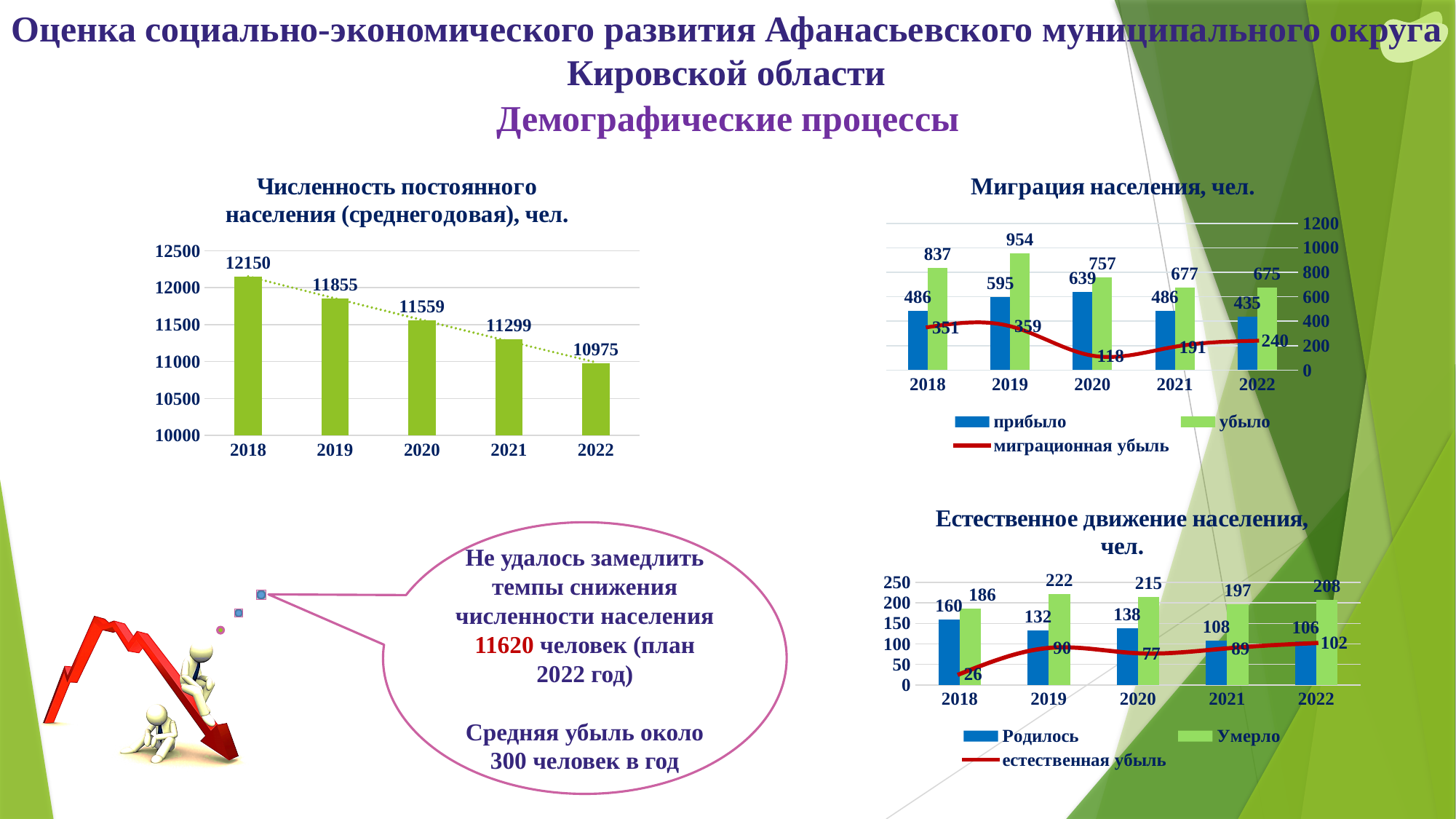
In the chart 'Численность постоянного населения (среднегодовая), чел.', do the values rise or fall from 2018 to 2022? fall In the chart 'Численность постоянного населения (среднегодовая), чел.', what is the value for 2020? 11559 In the chart 'Естественное движение населения, чел.', what is the value of 'Умерло' for 2021? 197 In the chart 'Миграция населения, чел.', which year has the lowest value of 'миграционная убыль'? 2020 In the chart 'Естественное движение населения, чел.', which is larger in 2019: 'Родилось' or 'Умерло'? Умерло In the chart 'Численность постоянного населения (среднегодовая), чел.', how many years are shown? 5 In the chart 'Численность постоянного населения (среднегодовая), чел.', what is the difference between the 2018 and 2022 values? 1175 In the chart 'Миграция населения, чел.', which year has the highest value of 'прибыло'? 2020 In the chart 'Миграция населения, чел.', what is the value of 'убыло' for 2019? 954 What kind of chart is 'Численность постоянного населения (среднегодовая), чел.'? bar chart In the chart 'Естественное движение населения, чел.', what is the difference between 'Умерло' and 'Родилось' in 2022? 102 In the chart 'Миграция населения, чел.', how many series does the legend list? 3